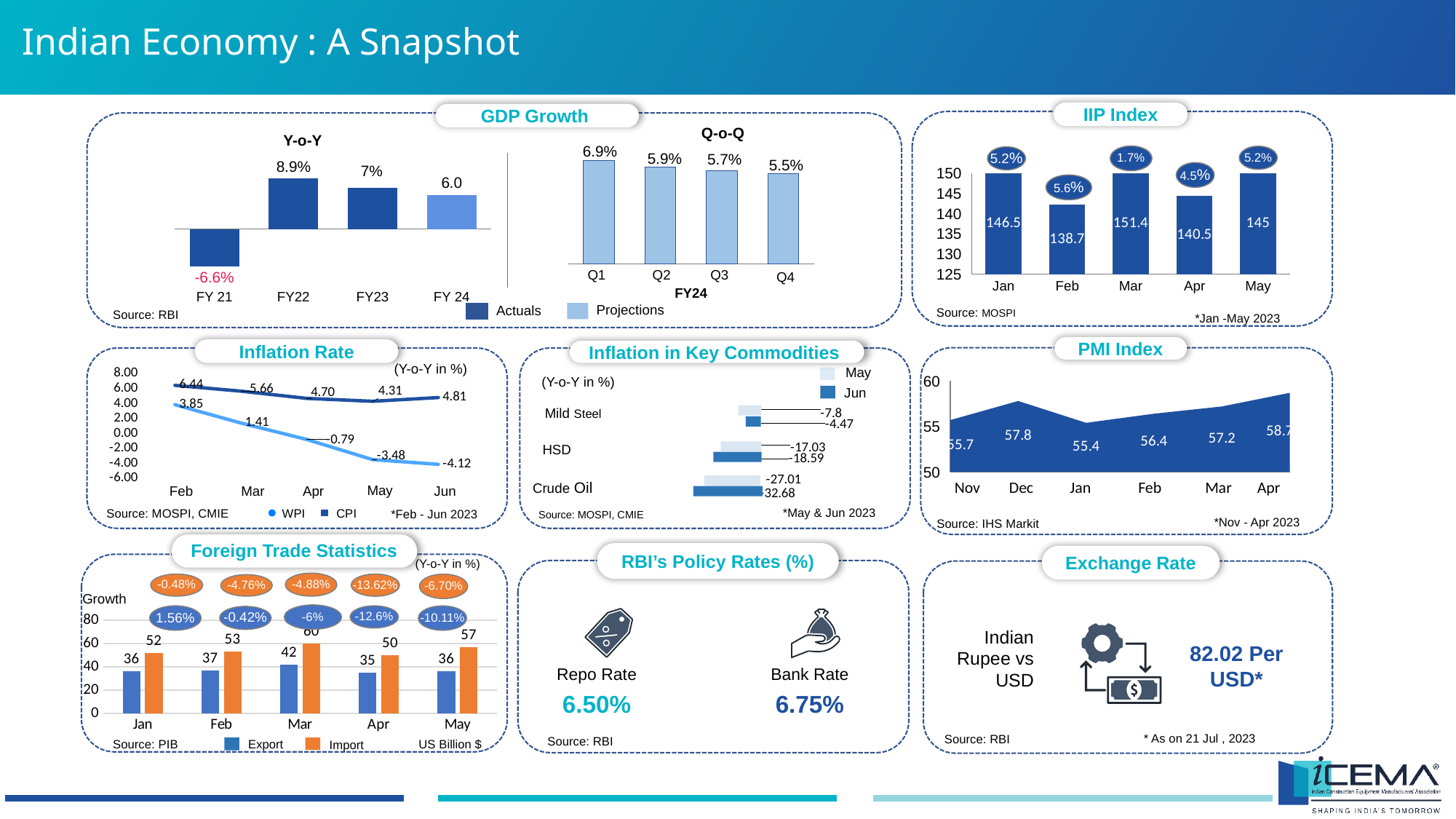
In the Inflation Rate chart, how many series does the legend list? 2 In the Foreign Trade Statistics chart, how many months are shown on the x axis? 5 In the Inflation in Key Commodities chart, what is the Jun value for Crude Oil? -32.68 What kind of chart is the PMI Index chart? area chart In the GDP Growth Q-o-Q FY24 chart, do the values rise or fall from Q1 to Q4? fall In the Foreign Trade Statistics chart, what is the difference between Import and Export for Mar? 18 In the GDP Growth Y-o-Y chart, what is the value for FY22? 8.9% In the Inflation Rate chart, what is the WPI value for Jun? -4.12 In the IIP Index chart, which month has the lowest value? Feb In the GDP Growth Y-o-Y chart, which fiscal year has the lowest value? FY 21 In the PMI Index chart, which month has the highest value? Apr In the IIP Index chart, what is the value for Mar? 151.4